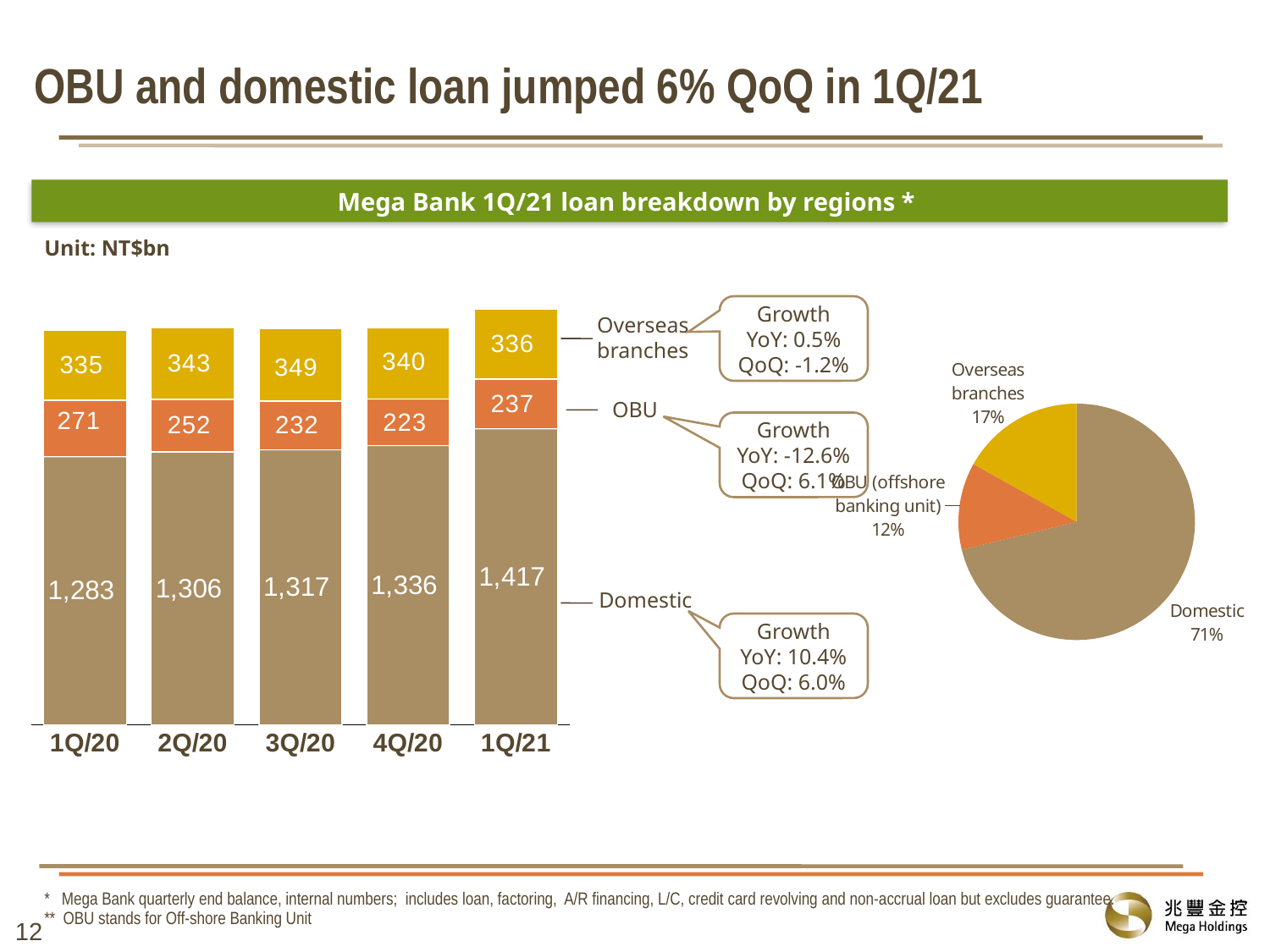
In the stacked bar chart, what is the Overseas branches loan value for 3Q/20? 349 In the stacked bar chart, by how much did the Domestic loan value increase from 4Q/20 to 1Q/21? 81 In the stacked bar chart, which quarter has the lowest OBU loan value? 4Q/20 In the stacked bar chart, what is the Domestic loan value for 1Q/21? 1,417 In the stacked bar chart, which quarter has the highest Domestic loan value? 1Q/21 In the stacked bar chart, which quarter has the larger OBU loan value, 1Q/20 or 2Q/20? 1Q/20 In the stacked bar chart, what is the total loan value for 1Q/21 (Domestic + OBU + Overseas branches)? 1,990 In the pie chart, what share of loans is Domestic? 71% How many quarters are shown on the x axis of the stacked bar chart? 5 In the stacked bar chart, what is the OBU loan value for 4Q/20? 223 In the stacked bar chart, does the Domestic loan value rise or fall from 1Q/20 to 1Q/21? Rises What type of chart is used to show the quarterly loan breakdown on the left of the slide? Stacked bar chart